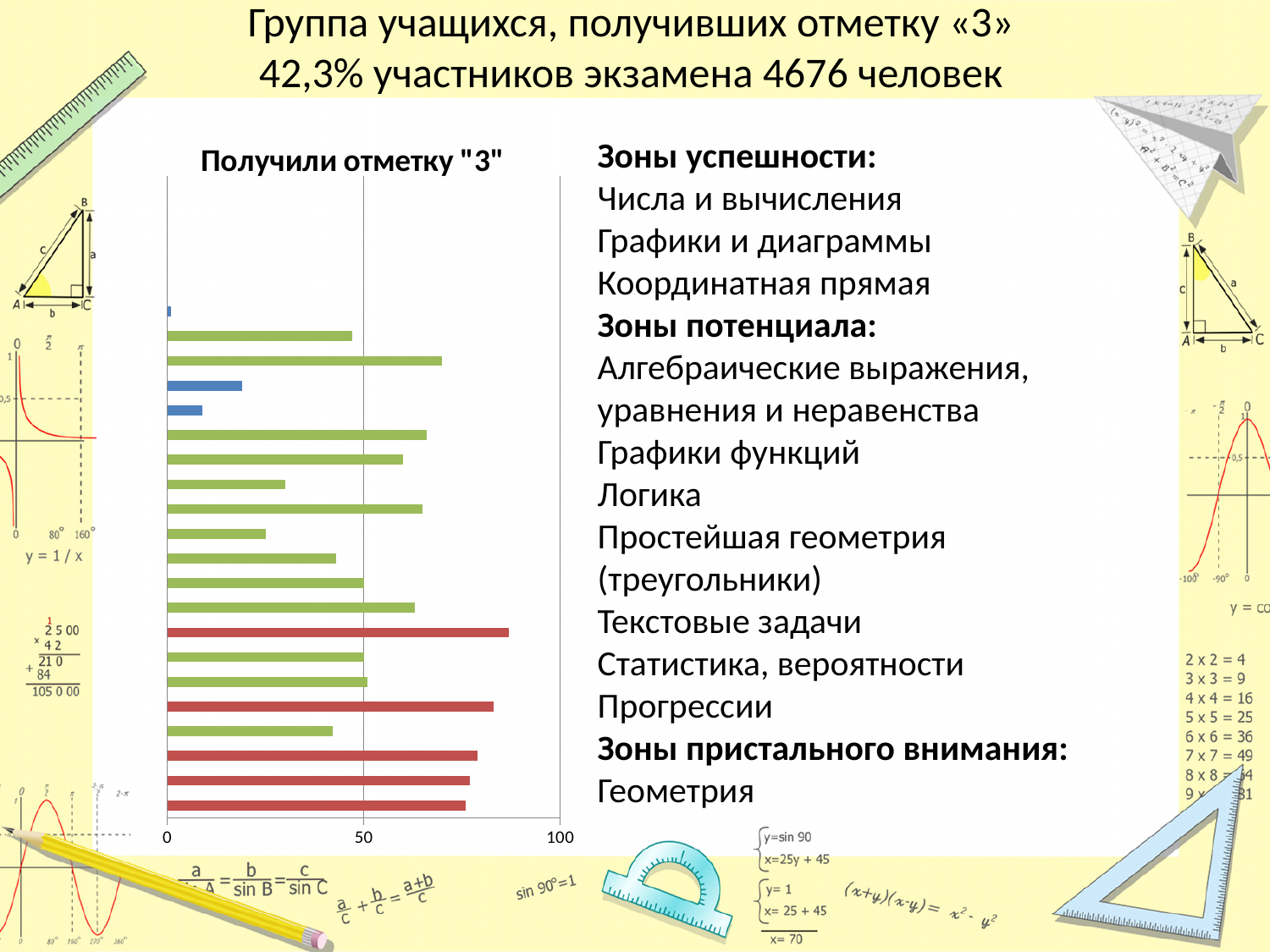
How many blue bars are there in the chart? 3 Is the value of the longest bar in the chart greater or less than 50? greater Which colour is the longest bar in the chart? red Which colour is the shortest bar in the chart? blue How many red bars are there in the chart? 5 Are all the red bars in the chart greater or less than 50? greater What is the highest value shown on the chart's horizontal axis? 100 What is the title of the chart? Получили отметку "3" Is the value of the topmost (first) bar in the chart greater or less than 50? less Which is larger: the longest red bar or the longest green bar? the longest red bar What kind of chart is shown on the slide? bar chart